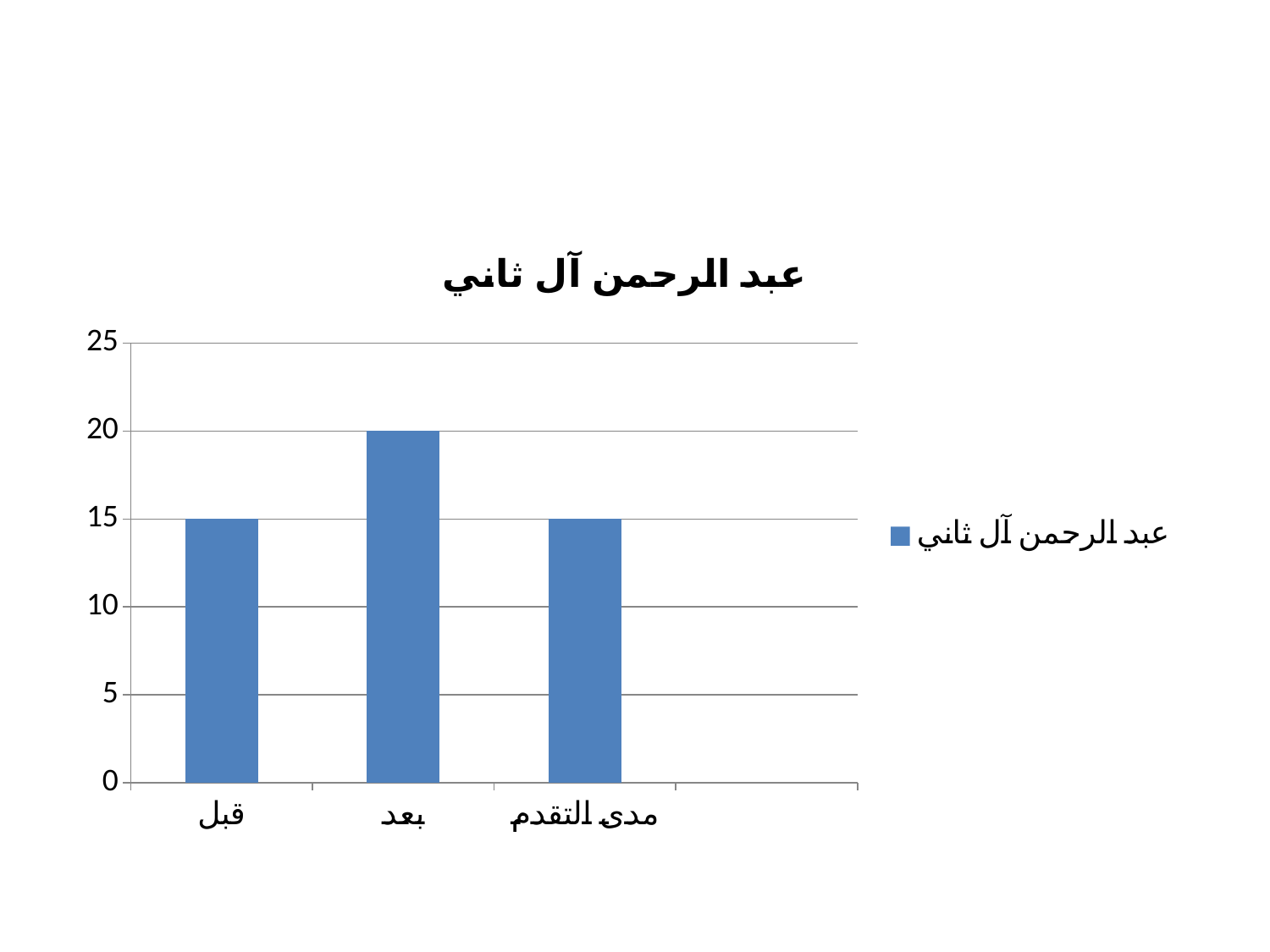
What is the difference between the values for بعد and قبل? 5 What is the value for مدى التقدم? 15 How many categories are shown on the x axis? 3 How many series does the legend list? 1 Which category has the highest value? بعد What is the title of the chart? عبد الرحمن آل ثاني Is the value for بعد greater or less than 15? greater What is the value for قبل? 15 What is the value for بعد? 20 Which is larger, the value for بعد or the value for مدى التقدم? بعد Is the value for قبل greater or less than 20? less What kind of chart is shown on the slide? bar chart